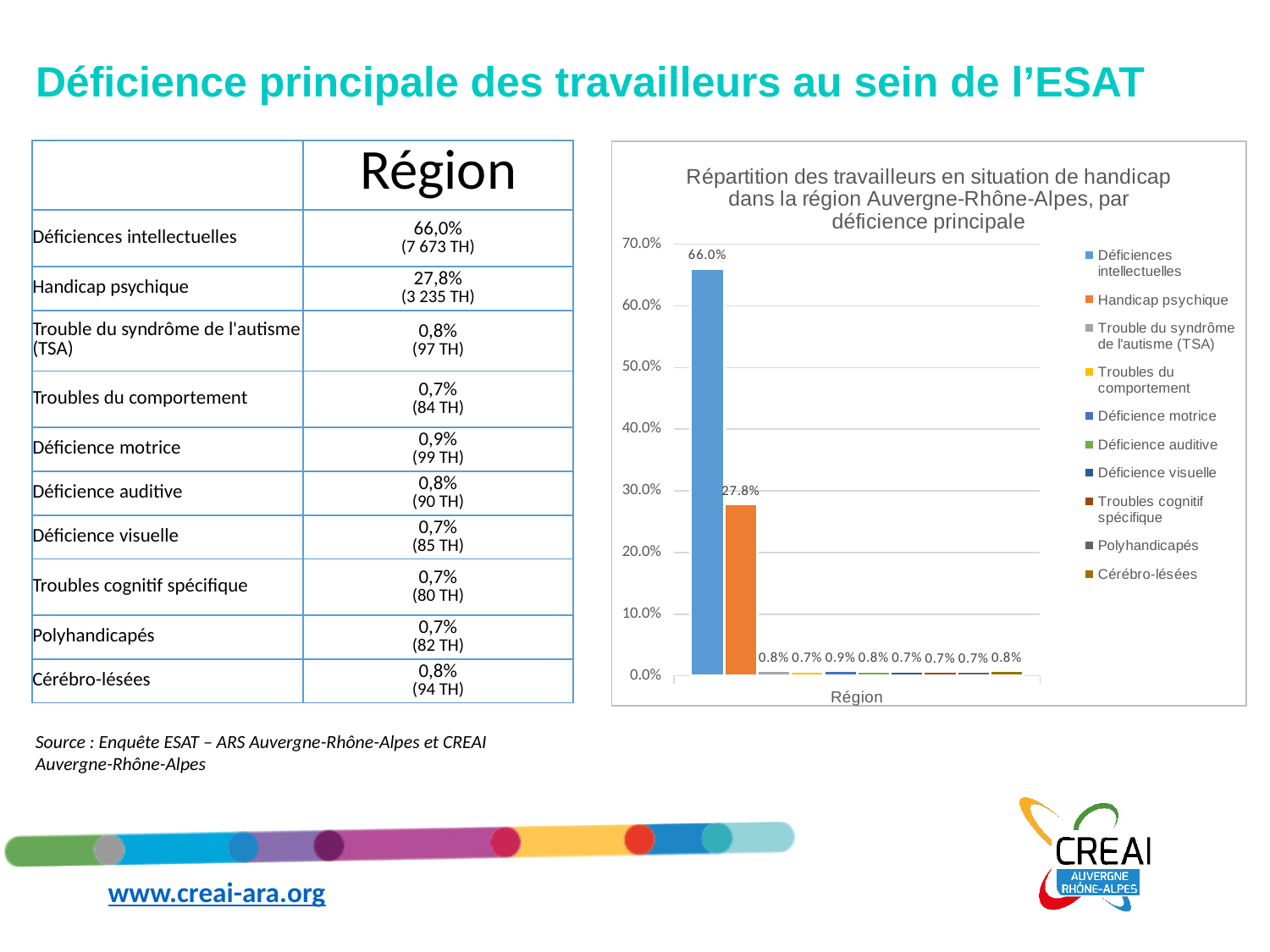
How many series does the chart legend list? 10 Is the value for Handicap psychique greater or less than 30.0%? less What is the value for Déficience motrice in the chart? 0.9% Which is larger, the value for Déficience motrice or the value for Troubles du comportement? Déficience motrice What is the value for Trouble du syndrôme de l'autisme (TSA) in the chart? 0.8% What is the difference between the values for Déficiences intellectuelles and Handicap psychique? 38.2% What type of chart is shown on the slide? Bar chart What is the value for Handicap psychique in the chart? 27.8% What is the title of the chart? Répartition des travailleurs en situation de handicap dans la région Auvergne-Rhône-Alpes, par déficience principale What is the category label shown on the x axis of the chart? Région Which series has the highest value in the chart? Déficiences intellectuelles What is the value for Déficiences intellectuelles in the chart? 66.0%